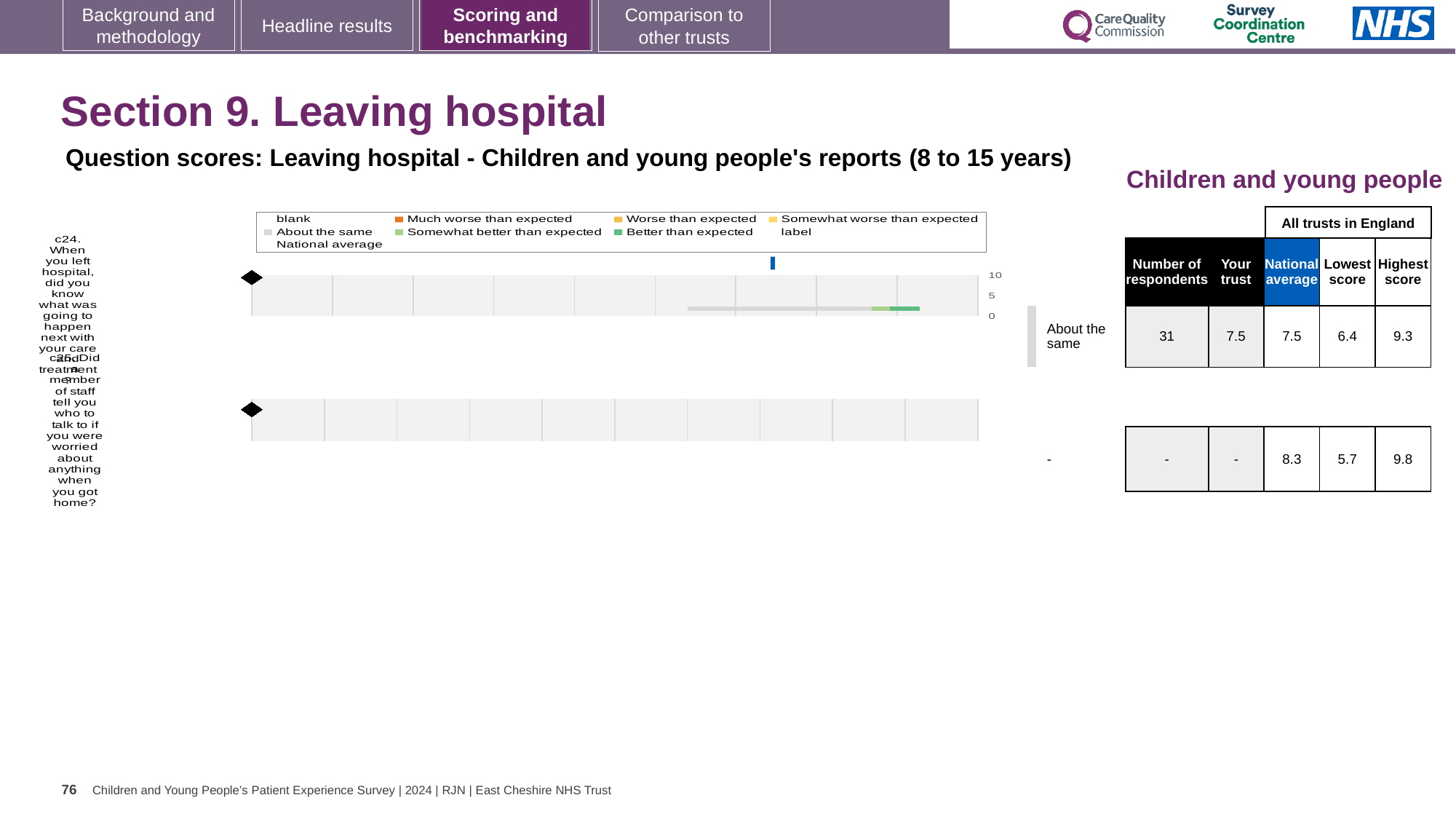
In the table next to the chart, what is the highest score for question c25? 9.8 How many questions (categories) are plotted in the Leaving hospital chart? 2 What is the highest tick value shown on the score axis of the Leaving hospital chart? 10 What kind of chart is used to show the question scores for Leaving hospital? bar chart Which legend entry in the Leaving hospital chart is shown in orange? Much worse than expected How many entries does the legend of the Leaving hospital chart list? 9 In the table next to the chart, what is the national average for question c24? 7.5 In the table next to the chart, what is the difference between the highest score and the lowest score for question c24? 2.9 In the table next to the chart, what is the lowest score for question c25? 5.7 In the table next to the chart, which question has the higher national average, c24 or c25? c25 In the table next to the chart, what is the number of respondents for question c24? 31 In the table next to the chart, what is the 'Your trust' score for question c24? 7.5